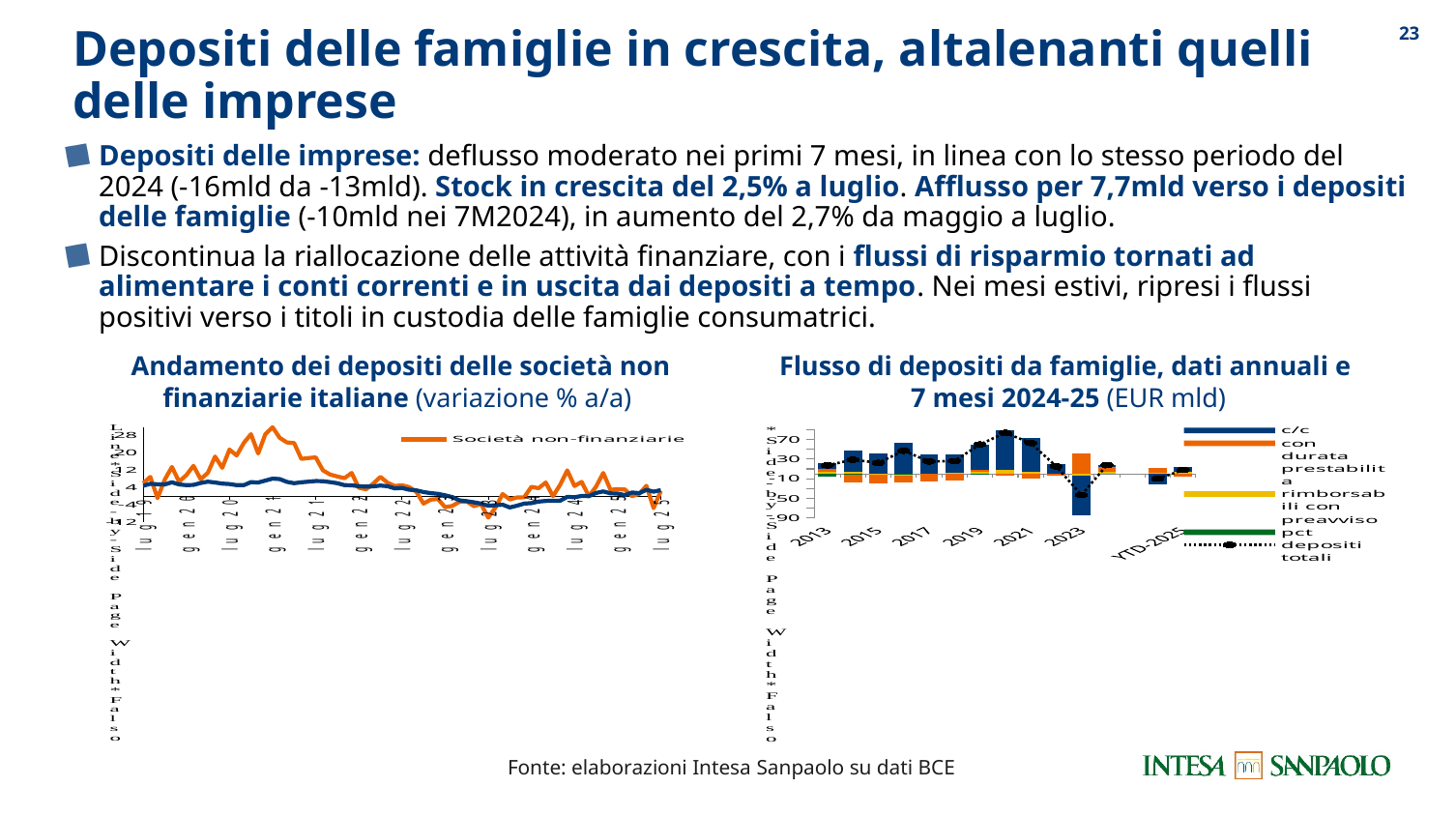
In the right chart, 'Flusso di depositi da famiglie', in which year is the c/c bar the tallest? 2020 How many series does the legend of the right chart, 'Flusso di depositi da famiglie', list? 5 In the left chart, 'Andamento dei depositi delle società non finanziarie italiane', is the peak of the 'Società non-finanziarie' line around gen 21 greater or less than 20? greater In the right chart, 'Flusso di depositi da famiglie', is the c/c value for 2023 greater or less than -10? less In the right chart, 'Flusso di depositi da famiglie', in which year is the c/c bar the lowest (most negative)? 2023 In the left chart, 'Andamento dei depositi delle società non finanziarie italiane', does the 'Società non-finanziarie' line rise or fall between lug 19 and gen 21? rise What kind of chart is the right chart, 'Flusso di depositi da famiglie'? combination of stacked bar and line chart In the right chart, 'Flusso di depositi da famiglie', is the c/c value for 2021 greater or less than 30? greater What unit is given in the title of the right chart, 'Flusso di depositi da famiglie'? EUR mld In the right chart, 'Flusso di depositi da famiglie', which legend entry is shown as a dotted line with markers? depositi totali What kind of chart is the left chart, 'Andamento dei depositi delle società non finanziarie italiane'? line chart In the left chart, 'Andamento dei depositi delle società non finanziarie italiane', does the 'Società non-finanziarie' line rise or fall between gen 21 and gen 23? fall